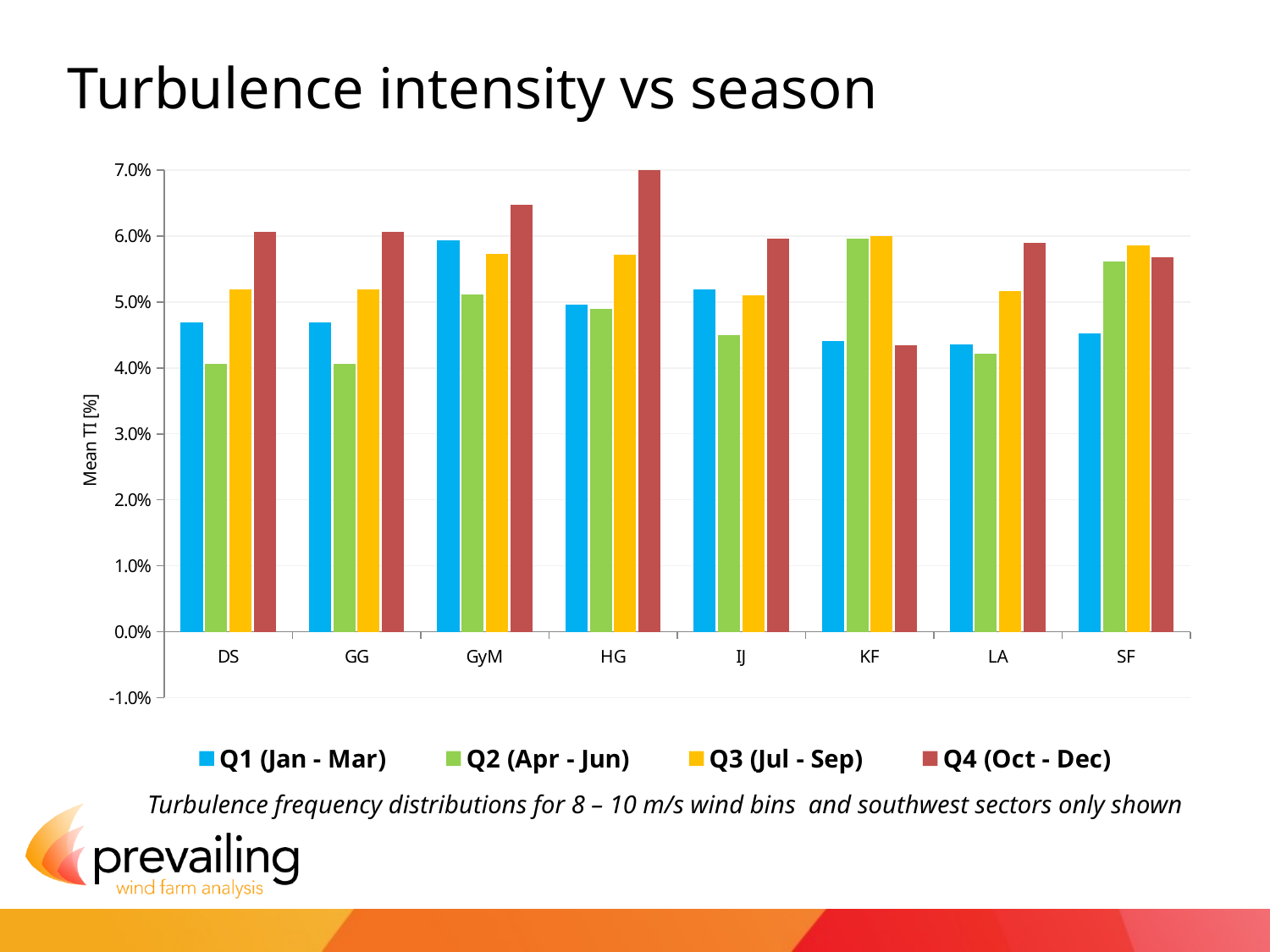
How many categories are shown on the x axis? 8 For SF, which is larger: the Q1 (Jan - Mar) value or the Q3 (Jul - Sep) value? Q3 (Jul - Sep) Which category has the highest Q1 (Jan - Mar) value? GyM What kind of chart is shown on the slide? bar chart Which category has the highest Q4 (Oct - Dec) value? HG For KF, which is larger: the Q1 (Jan - Mar) value or the Q2 (Apr - Jun) value? Q2 (Apr - Jun) Is the Q2 (Apr - Jun) value for DS greater or less than 5.0%? less How many series does the legend list? 4 What is the label of the y axis? Mean TI [%] Is the Q4 (Oct - Dec) value for HG greater or less than 6.0%? greater Is the Q1 (Jan - Mar) value for GyM greater or less than 5.0%? greater